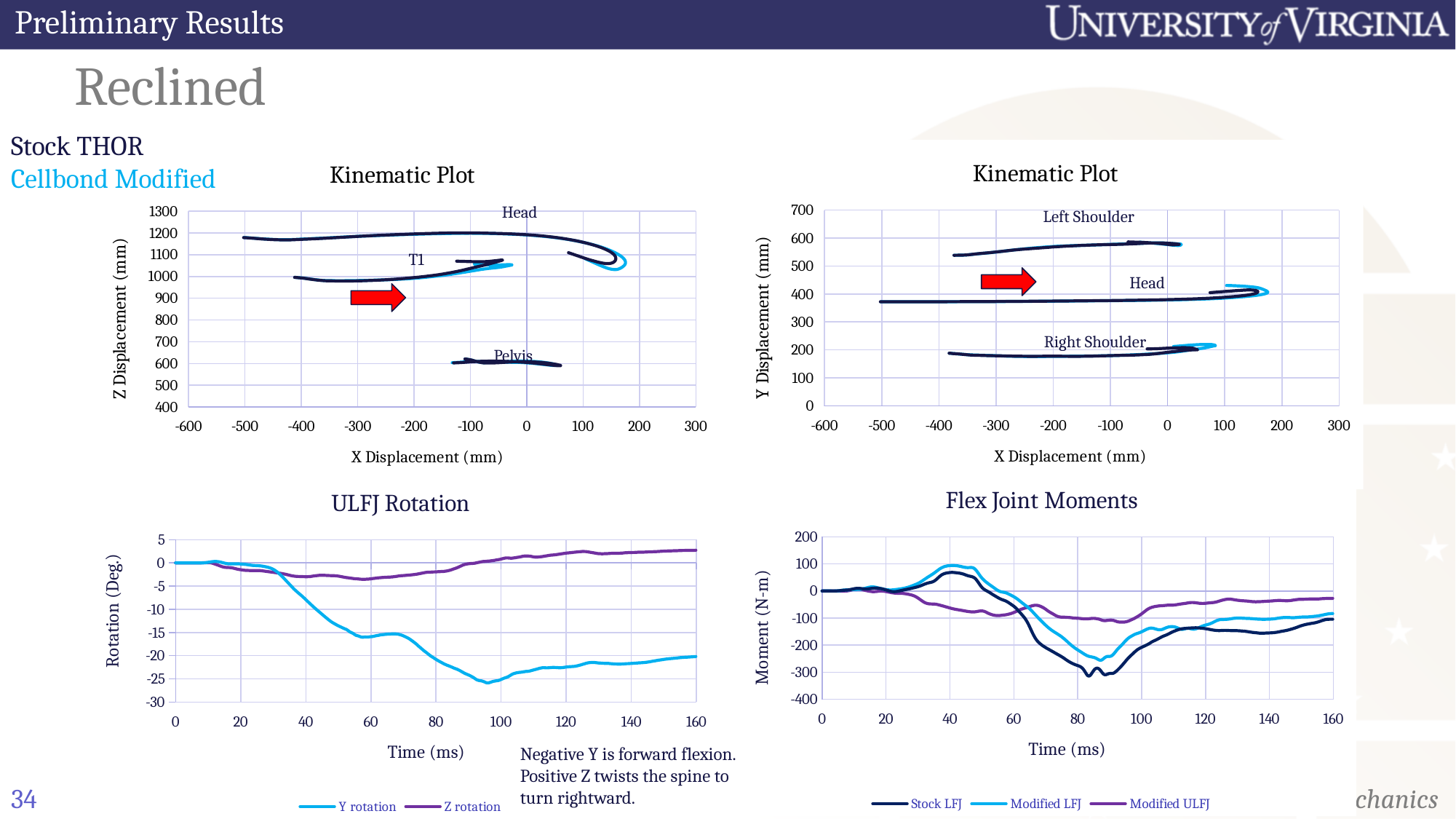
On the Flex Joint Moments chart, which series reaches the lowest moment? Stock LFJ On the Flex Joint Moments chart, is the Modified ULFJ value at 160 ms greater or less than -100? greater On the top-left Kinematic Plot, what is the label of the vertical axis? Z Displacement (mm) On the ULFJ Rotation chart, is the Z rotation value at 160 ms greater or less than 0? greater What kind of chart is the ULFJ Rotation chart? line chart On the ULFJ Rotation chart, is the Y rotation value at 100 ms greater or less than -20? less On the ULFJ Rotation chart, how many series does the legend list? 2 On the ULFJ Rotation chart, does the Y rotation rise or fall between 40 ms and 100 ms? fall On the top-right Kinematic Plot, how many labeled body locations are plotted? 3 On the Flex Joint Moments chart, how many series does the legend list? 3 On the ULFJ Rotation chart, which series reaches the lowest rotation value? Y rotation